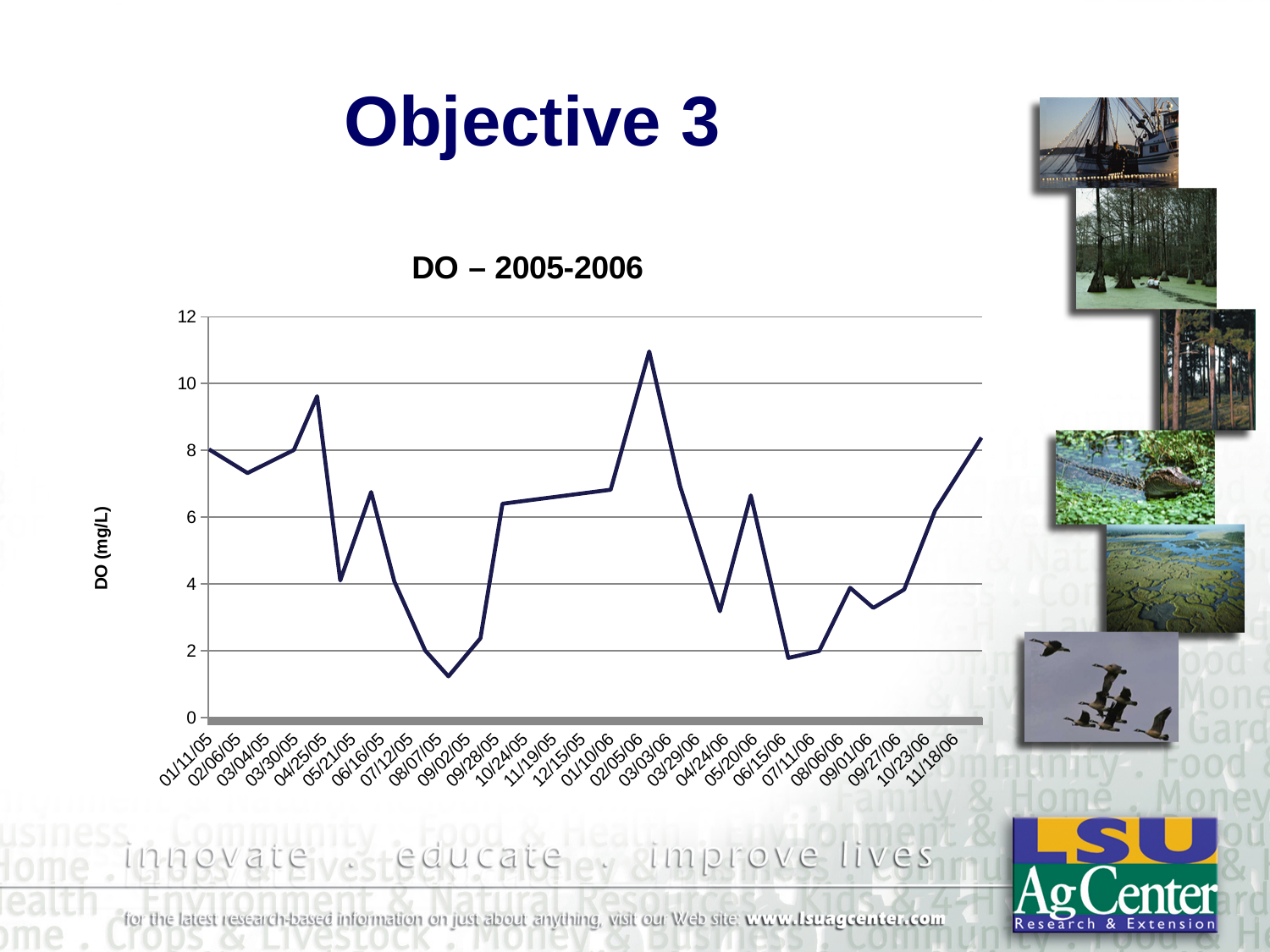
Is the value for 08/07/05 greater or less than 2? less What is the title of the chart? DO – 2005-2006 Does the DO value rise or fall between 04/25/05 and 08/07/05? fall Is the value for 02/05/06 greater or less than 10? greater Which date has the larger DO value, 04/25/05 or 05/21/05? 04/25/05 What kind of chart is shown on the slide? line chart On which date is the DO value highest? 02/05/06 How many dates are plotted along the x axis? 27 On which date is the DO value lowest? 08/07/05 What is the label of the y axis? DO (mg/L)